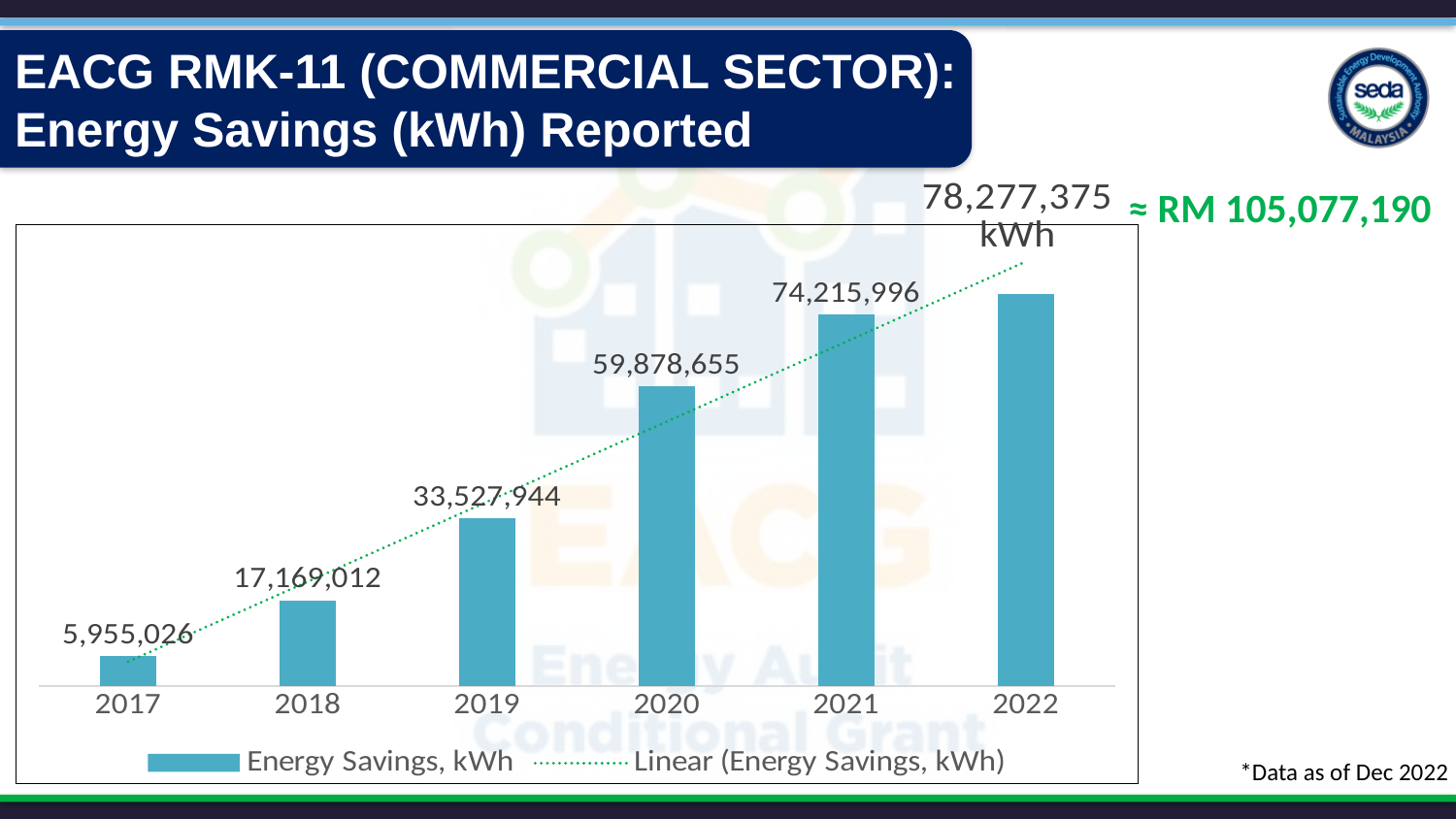
What is the energy savings value for 2019? 33,527,944 How many entries does the legend list? 2 What is the difference in energy savings between 2018 and 2017? 11,213,986 What is the energy savings value for 2021? 74,215,996 How many years are shown on the x axis? 6 Which year has the highest energy savings? 2022 Which year has the lowest energy savings? 2017 What is the difference in energy savings between 2022 and 2021? 4,061,379 What kind of chart is shown on the slide? Bar chart Do the energy savings values rise or fall from 2017 to 2022? Rise What is the energy savings value for 2017? 5,955,026 Which year has larger energy savings, 2019 or 2020? 2020